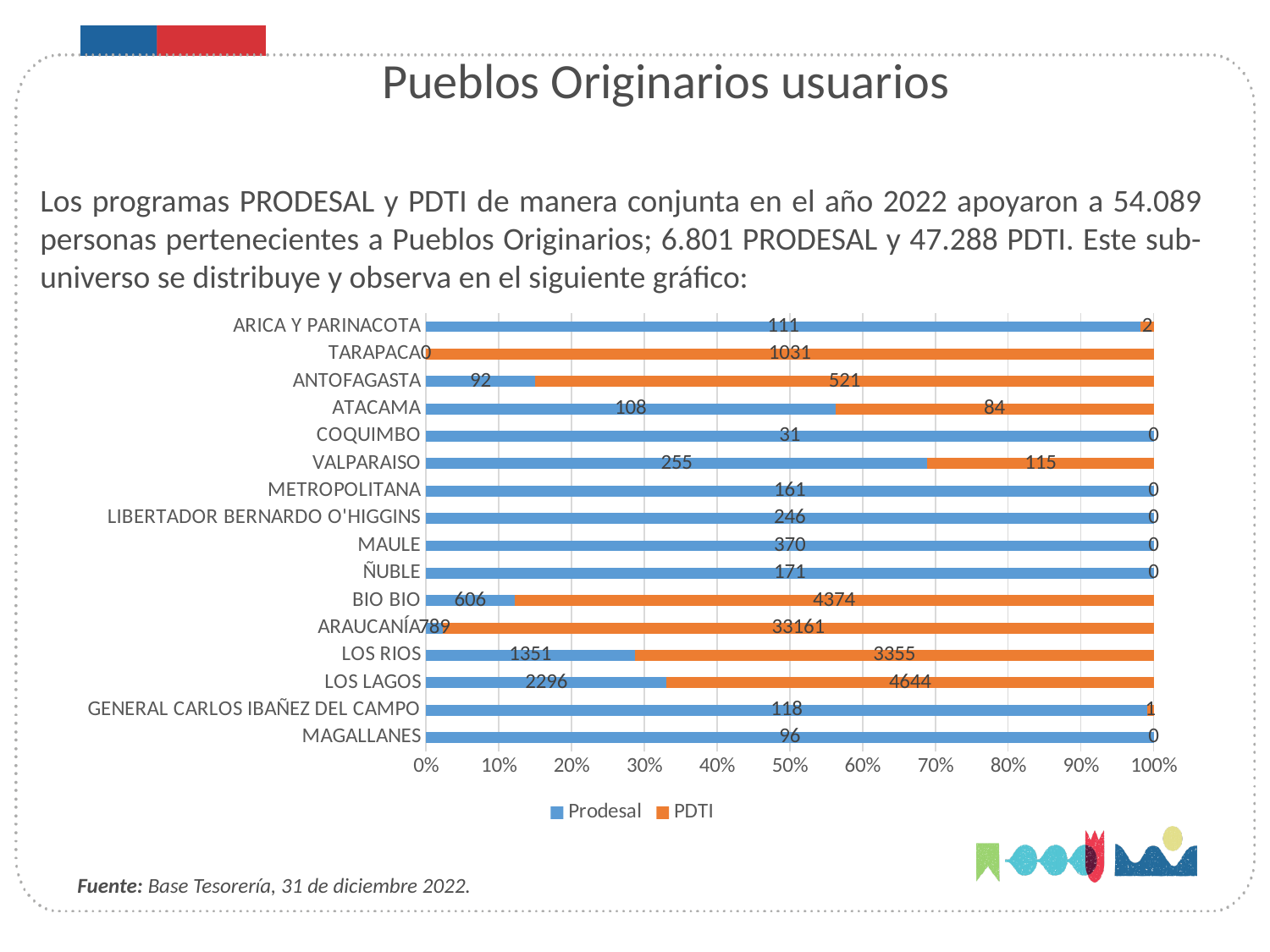
Which is larger for VALPARAISO, the Prodesal value or the PDTI value? Prodesal How many regions are shown on the chart? 16 Which region has the lowest Prodesal value? TARAPACA What is the Prodesal value for LOS LAGOS? 2296 How many series does the legend list? 2 What kind of chart is shown on the slide? Stacked bar chart What is the PDTI value for TARAPACA? 1031 What is the PDTI value for BIO BIO? 4374 Which region has the highest Prodesal value? LOS LAGOS What is the difference between the PDTI and Prodesal values for LOS RIOS? 2004 What is the total of Prodesal and PDTI for LOS LAGOS? 6940 Which region has the highest PDTI value? ARAUCANÍA